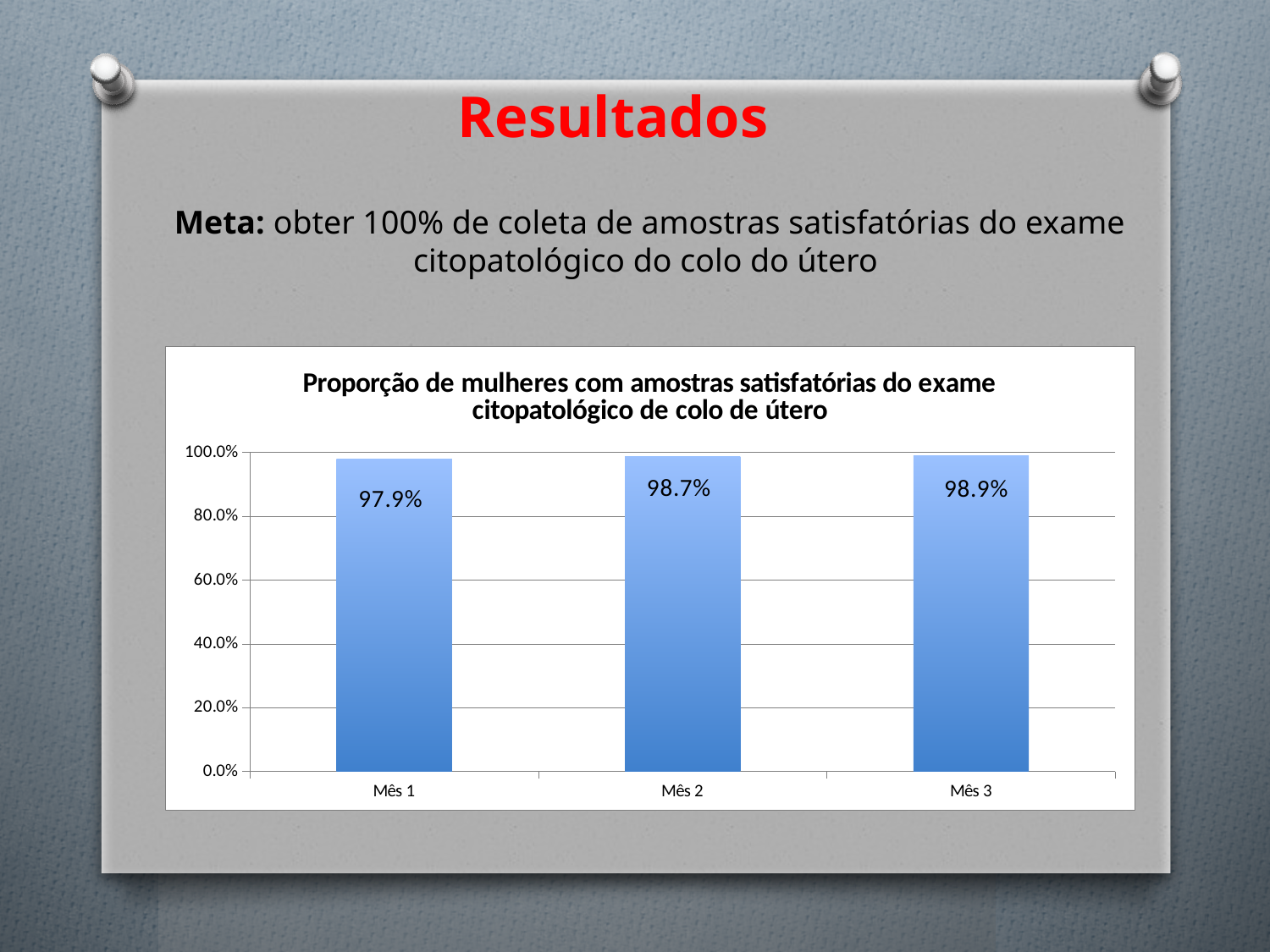
Which month has the highest proportion? Mês 3 Do the values rise or fall from Mês 1 to Mês 3? rise Which is larger, the value for Mês 2 or the value for Mês 3? Mês 3 What kind of chart is shown on the slide? bar chart Which month has the lowest proportion? Mês 1 What is the value for Mês 2? 98.7% How many categories are shown on the x axis? 3 What is the value for Mês 3? 98.9% What is the difference between the values for Mês 3 and Mês 1? 1.0% What is the value for Mês 1? 97.9% Is the value for Mês 1 greater or less than 80.0%? greater What is the difference between the values for Mês 2 and Mês 1? 0.8%